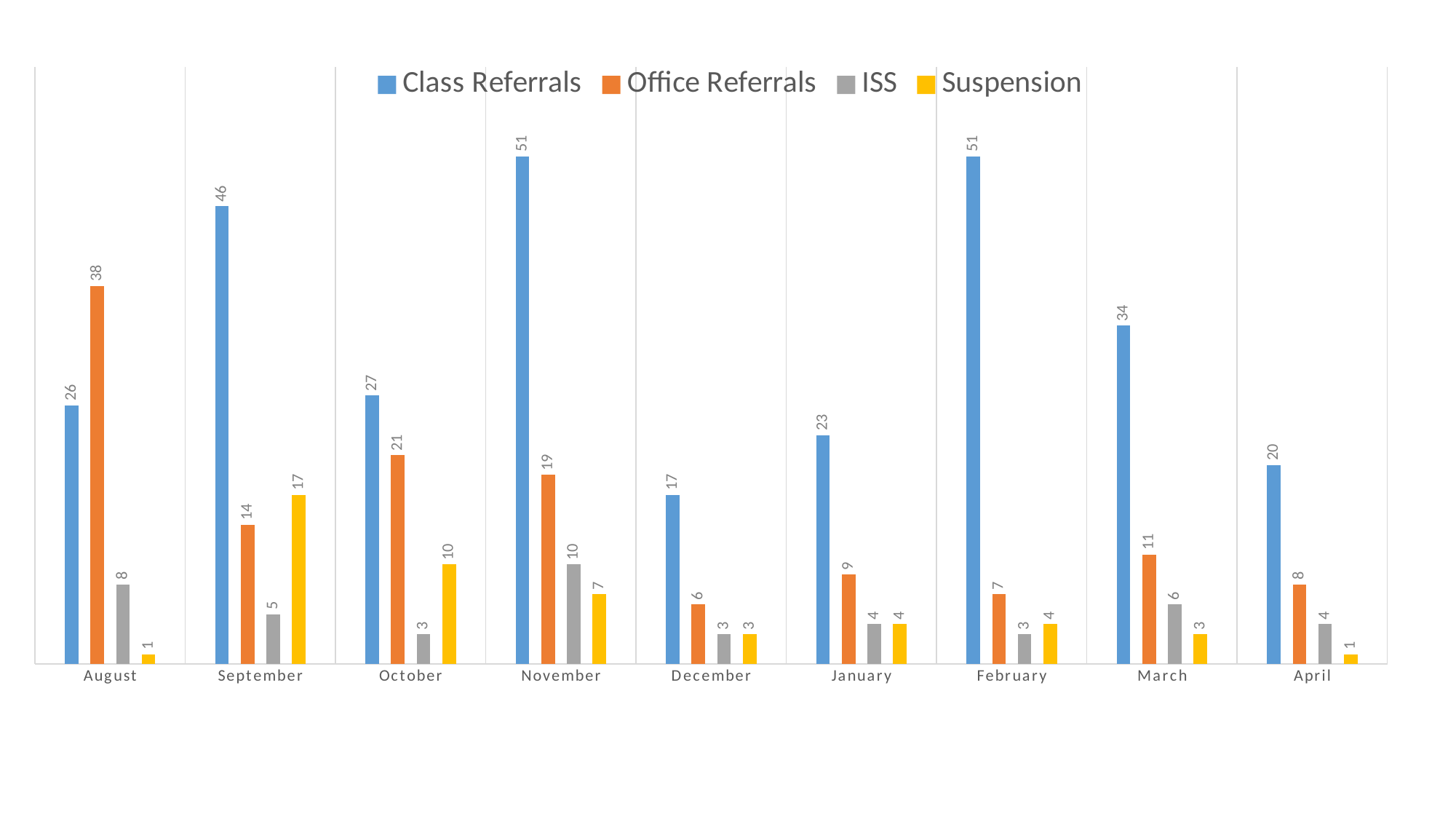
What is the value of Office Referrals for August? 38 Which is larger in August: Class Referrals or Office Referrals? Office Referrals How many months are shown on the x axis? 9 Which month has the lowest Class Referrals value? December What is the value of Suspension for September? 17 What is the value of Class Referrals for November? 51 What is the value of ISS for October? 3 Which month has the highest Office Referrals value? August What is the difference between Class Referrals and Office Referrals in March? 23 How many series does the legend list? 4 Which colour represents the Suspension series in the legend? Yellow What kind of chart is shown on the slide? Bar chart